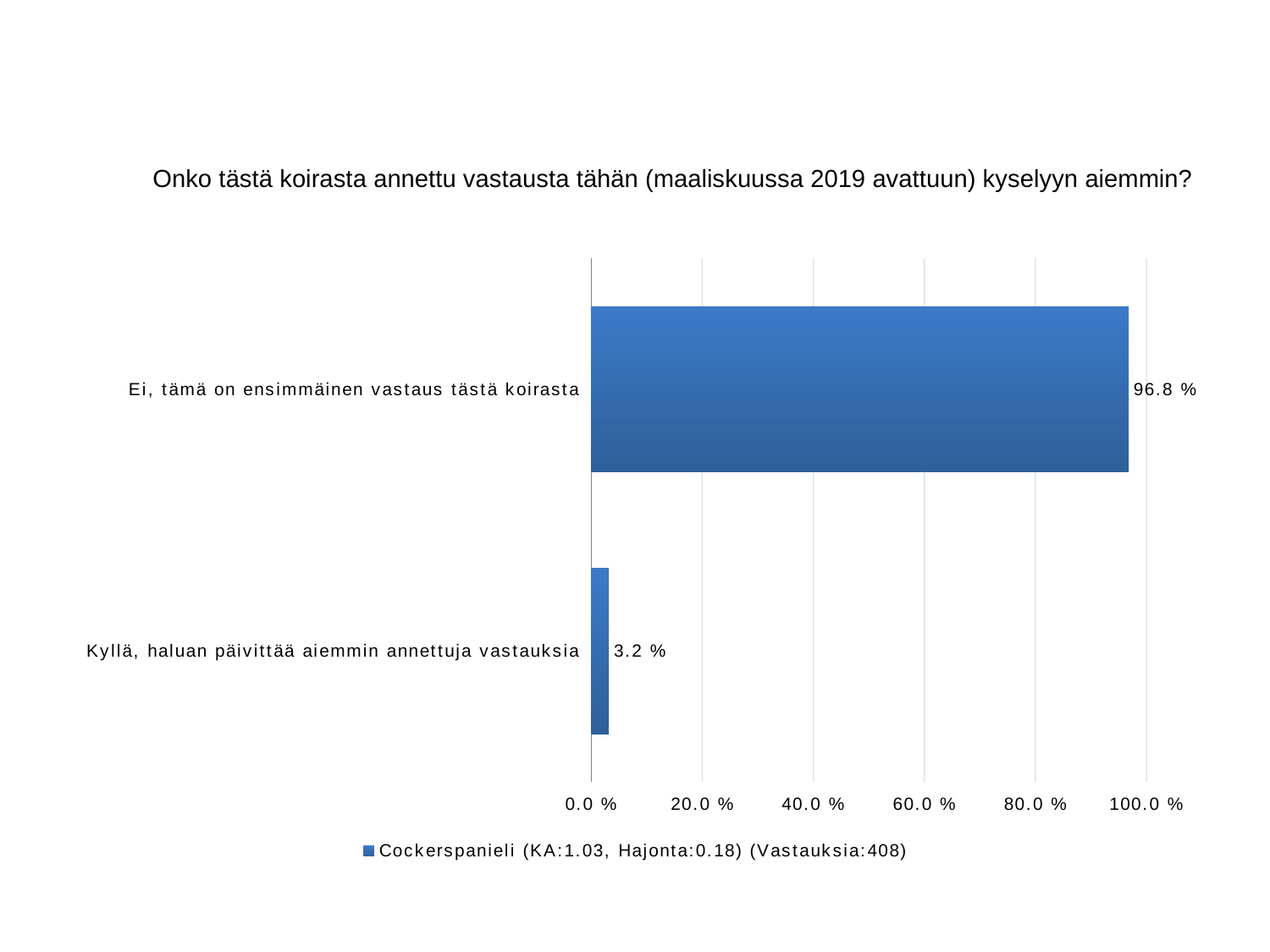
Is the value for "Kyllä, haluan päivittää aiemmin annettuja vastauksia" greater or less than 20.0 %? less Is the value for "Ei, tämä on ensimmäinen vastaus tästä koirasta" greater or less than 80.0 %? greater How many series does the legend list? 1 What is the value for "Ei, tämä on ensimmäinen vastaus tästä koirasta"? 96.8 % Which is larger: the value for "Ei, tämä on ensimmäinen vastaus tästä koirasta" or for "Kyllä, haluan päivittää aiemmin annettuja vastauksia"? Ei, tämä on ensimmäinen vastaus tästä koirasta How many categories are shown in the chart? 2 What is the legend entry of the chart? Cockerspanieli (KA:1.03, Hajonta:0.18) (Vastauksia:408) What is the value for "Kyllä, haluan päivittää aiemmin annettuja vastauksia"? 3.2 % Which category has the highest value? Ei, tämä on ensimmäinen vastaus tästä koirasta What is the difference between the values for "Ei, tämä on ensimmäinen vastaus tästä koirasta" and "Kyllä, haluan päivittää aiemmin annettuja vastauksia"? 93.6 % What kind of chart is shown on the slide? bar chart Which category has the lowest value? Kyllä, haluan päivittää aiemmin annettuja vastauksia